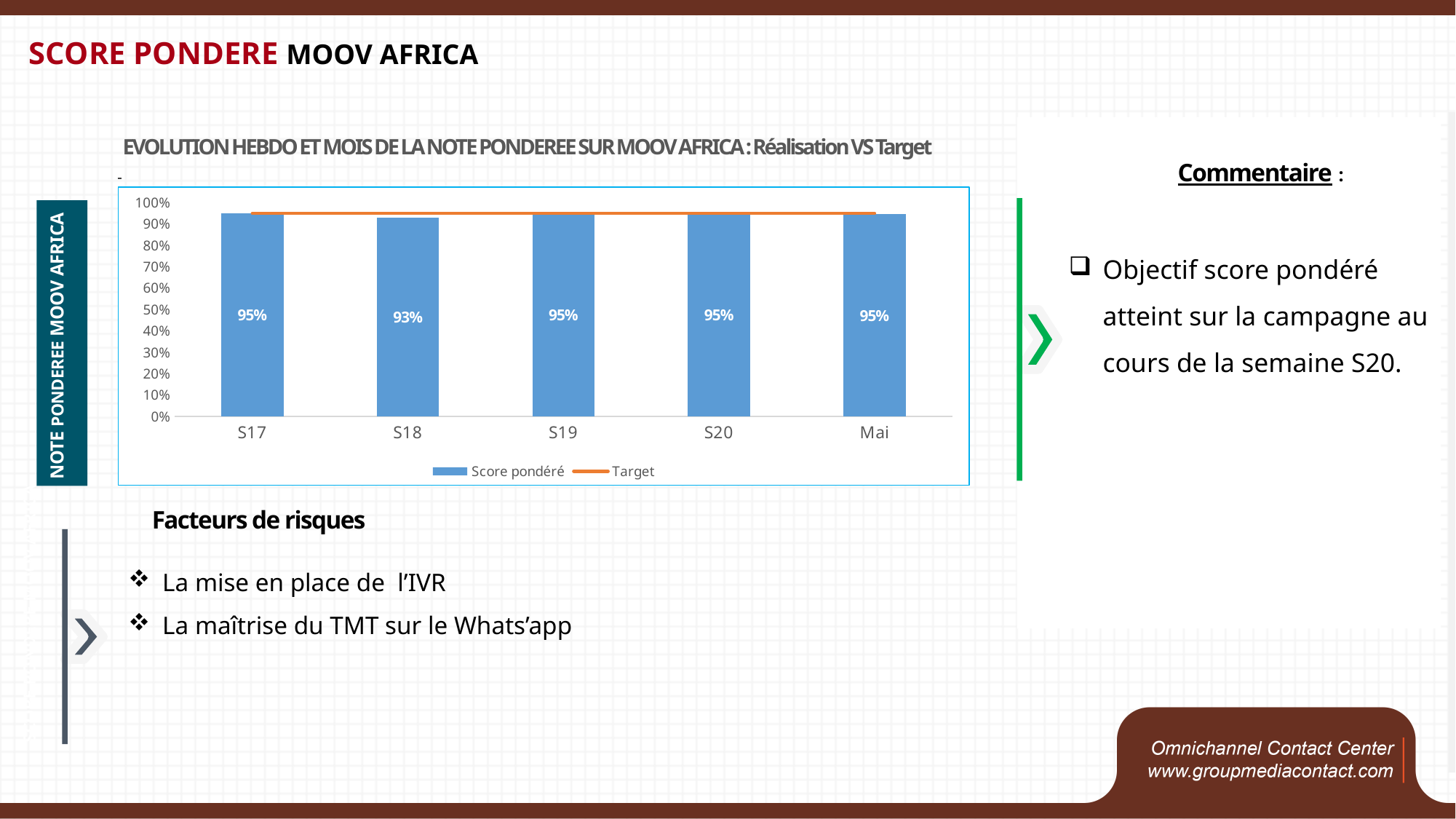
What kind of chart is shown on the slide? Combination bar and line chart What is the Score pondéré value for Mai? 95% What is the Score pondéré value for S18? 93% What is the difference between the Score pondéré for S17 and S18? 2% What are the two entries in the chart legend? Score pondéré and Target Which has a higher Score pondéré, S18 or S19? S19 What colour are the Score pondéré bars in the chart? Blue What is the Score pondéré value for S17? 95% Which category has the lowest Score pondéré? S18 How many categories are shown on the x axis of the chart? 5 Is the Score pondéré value for S18 greater or less than 90%? greater How many series does the chart legend list? 2